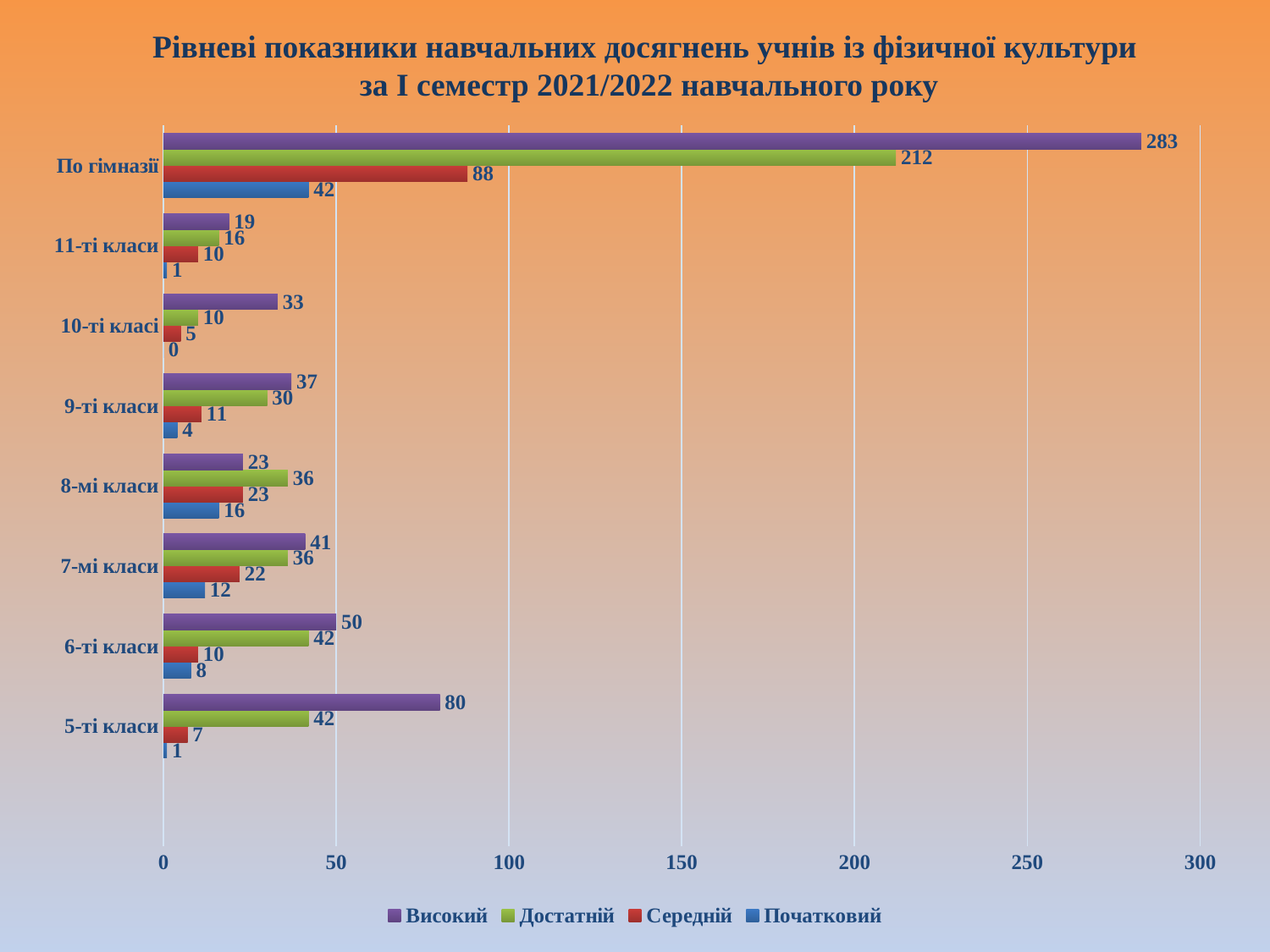
What is the value of Початковий for 10-ті класі? 0 How many series does the legend list? 4 Which category has the lowest Середній value? 10-ті класі What is the value of Високий for По гімназії? 283 What is the difference between Достатній and Середній for По гімназії? 124 Which is larger for 8-мі класи: Високий or Достатній? Достатній What is the value of Достатній for 5-ті класи? 42 Which class category has the highest Високий value (excluding По гімназії)? 5-ті класи Is the value of Достатній for По гімназії greater or less than 200? greater How many categories are shown on the vertical axis? 8 Which series is shown in green in the legend? Достатній What type of chart is shown on the slide? bar chart